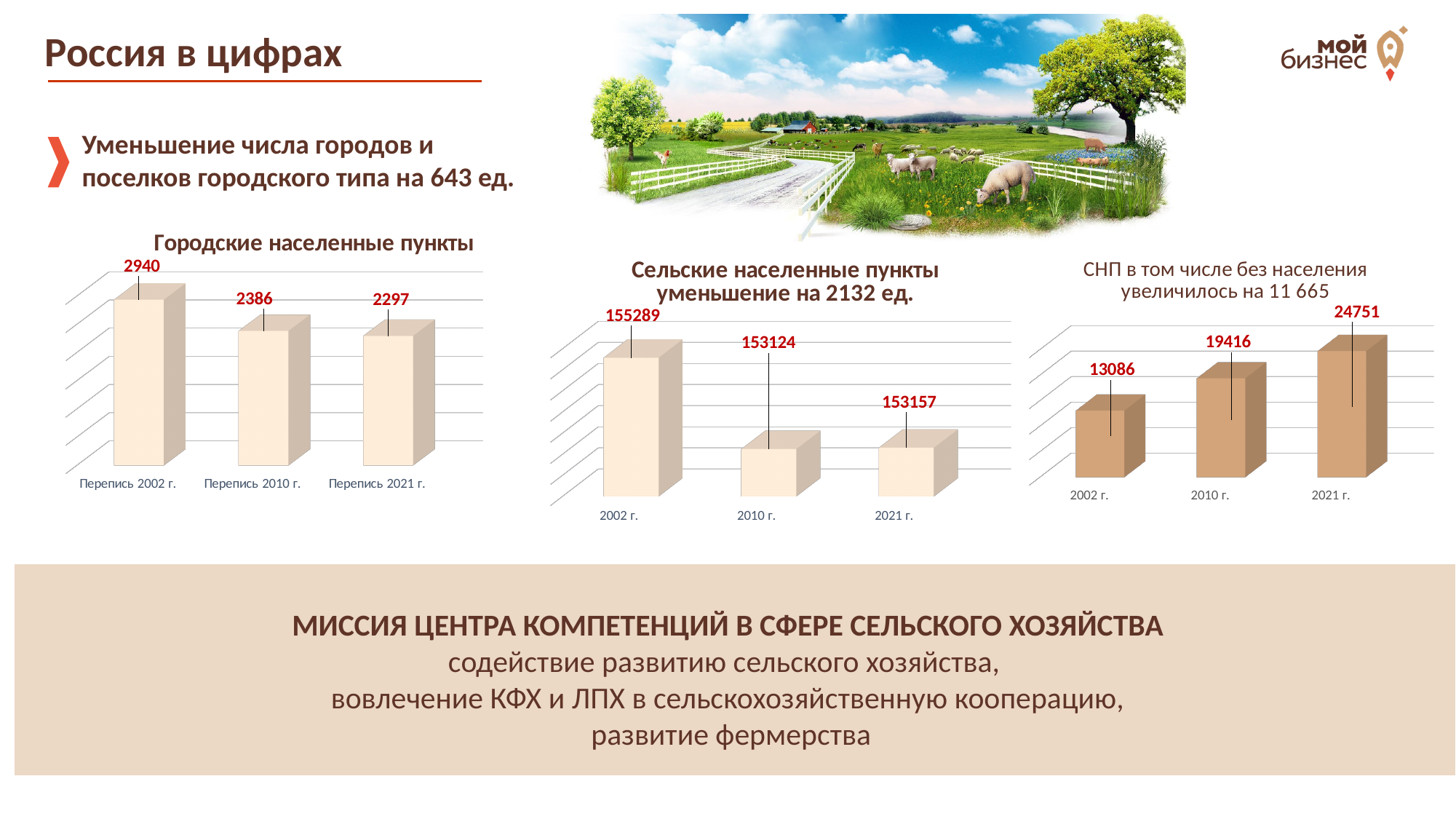
In the chart 'СНП в том числе без населения', what is the value for 2010 г.? 19416 In the chart 'Городские населенные пункты', what is the difference between the values for Перепись 2002 г. and Перепись 2010 г.? 554 In the chart 'СНП в том числе без населения', which year has the highest value? 2021 г. In the chart 'СНП в том числе без населения', what is the difference between the values for 2021 г. and 2002 г.? 11665 In the chart 'Городские населенные пункты', what is the value for Перепись 2002 г.? 2940 In the chart 'Городские населенные пункты', what is the value for Перепись 2021 г.? 2297 In the chart 'Сельские населенные пункты', what is the value for 2002 г.? 155289 How many bars are in the chart 'СНП в том числе без населения'? 3 In the chart 'Сельские населенные пункты', what is the difference between the values for 2002 г. and 2021 г.? 2132 In the chart 'Сельские населенные пункты', which is larger, the value for 2010 г. or 2021 г.? 2021 г. In the chart 'Городские населенные пункты', do the values rise or fall from 2002 to 2021? fall In the chart 'Сельские населенные пункты', which year has the lowest value? 2010 г.